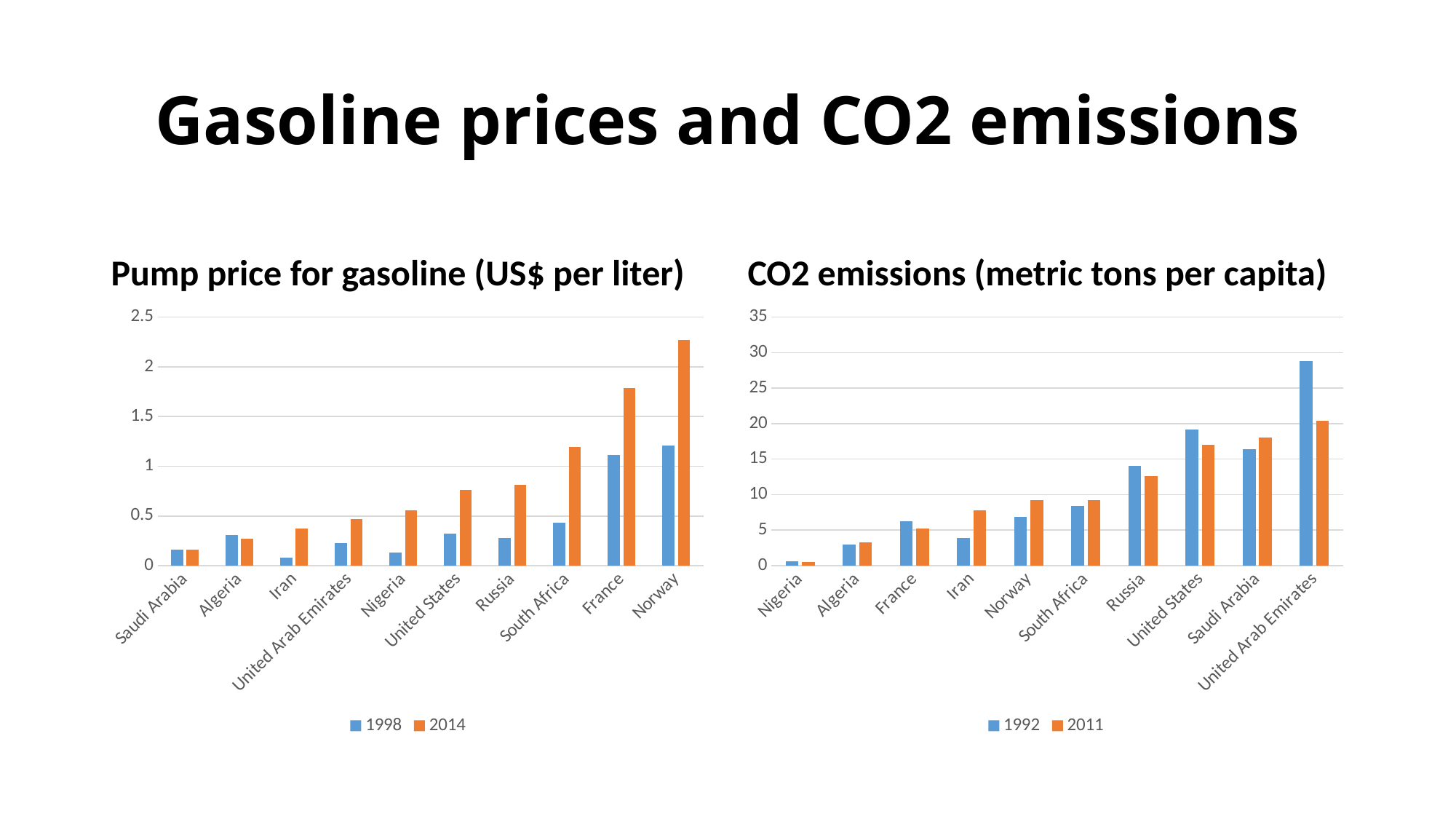
On the 'CO2 emissions (metric tons per capita)' chart, is the 1992 value for United Arab Emirates greater or less than 25? greater How many countries are shown on the 'Pump price for gasoline (US$ per liter)' chart? 10 On the 'CO2 emissions (metric tons per capita)' chart, which country has the highest 1992 value? United Arab Emirates What kind of chart is the 'Pump price for gasoline (US$ per liter)' chart? bar chart On the 'CO2 emissions (metric tons per capita)' chart, which is larger for United States: the 1992 value or the 2011 value? 1992 On the 'Pump price for gasoline (US$ per liter)' chart, is the 2014 value for Norway greater or less than 2? greater On the 'Pump price for gasoline (US$ per liter)' chart, which country has the lowest 1998 value? Iran Which years does the legend of the 'Pump price for gasoline (US$ per liter)' chart list? 1998 and 2014 How many series does the legend of the 'CO2 emissions (metric tons per capita)' chart list? 2 On the 'CO2 emissions (metric tons per capita)' chart, which country has the lowest 2011 value? Nigeria On the 'Pump price for gasoline (US$ per liter)' chart, which country has the highest 2014 value? Norway On the 'Pump price for gasoline (US$ per liter)' chart, is the 2014 value for United States greater or less than 1? less